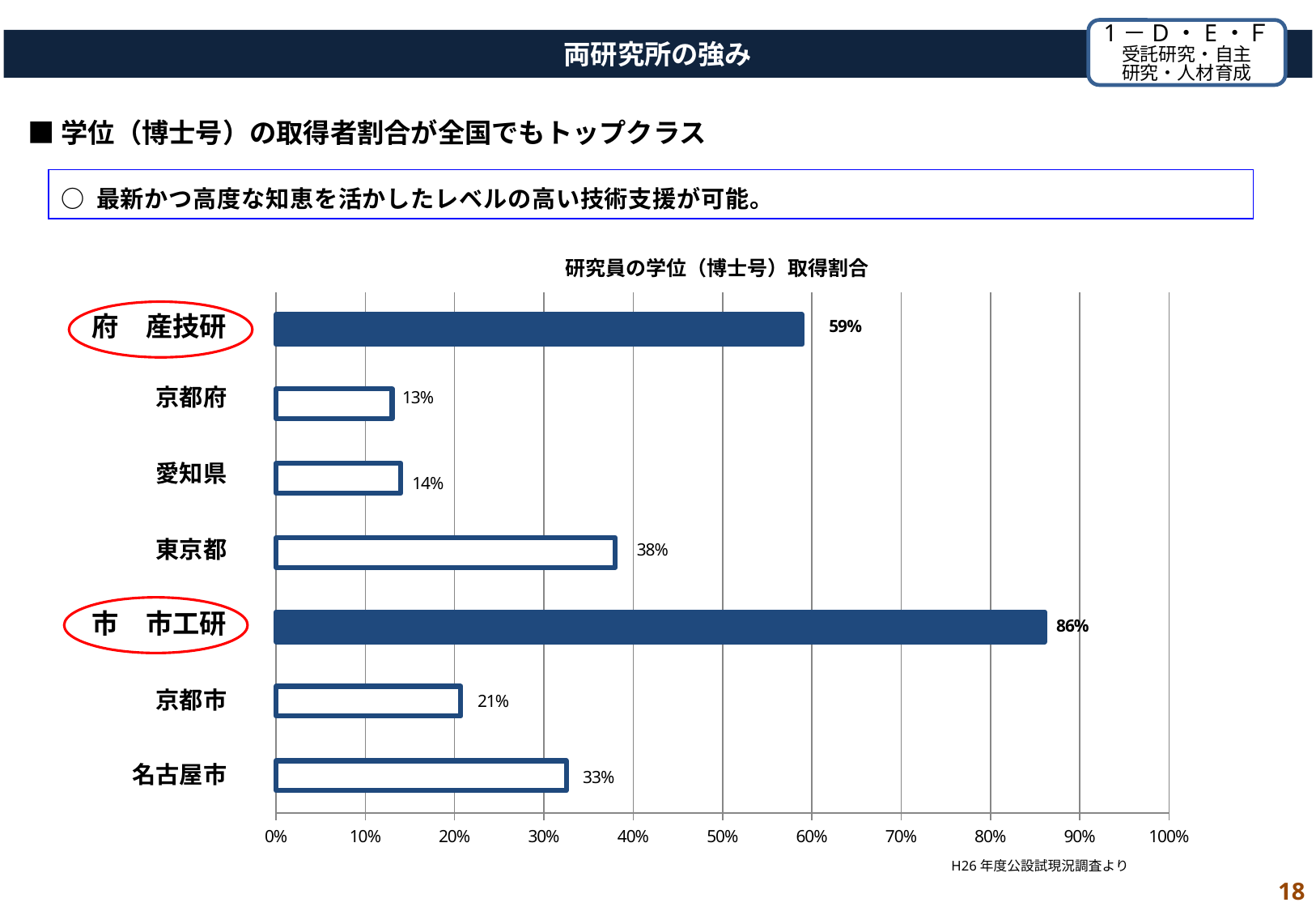
What is the value for 府 産技研 in the chart 研究員の学位（博士号）取得割合? 59% Which is larger, the value for 愛知県 or the value for 京都市? 京都市 What is the value for 東京都? 38% What is the value for 市 市工研? 86% What is the value for 名古屋市? 33% Which category has the lowest value? 京都府 What is the difference between the values for 市 市工研 and 府 産技研? 27% Which category has the highest value? 市 市工研 What is the title of the chart? 研究員の学位（博士号）取得割合 What kind of chart is shown on the slide? Bar chart What is the difference between the values for 東京都 and 京都市? 17% How many categories are shown in the chart? 7